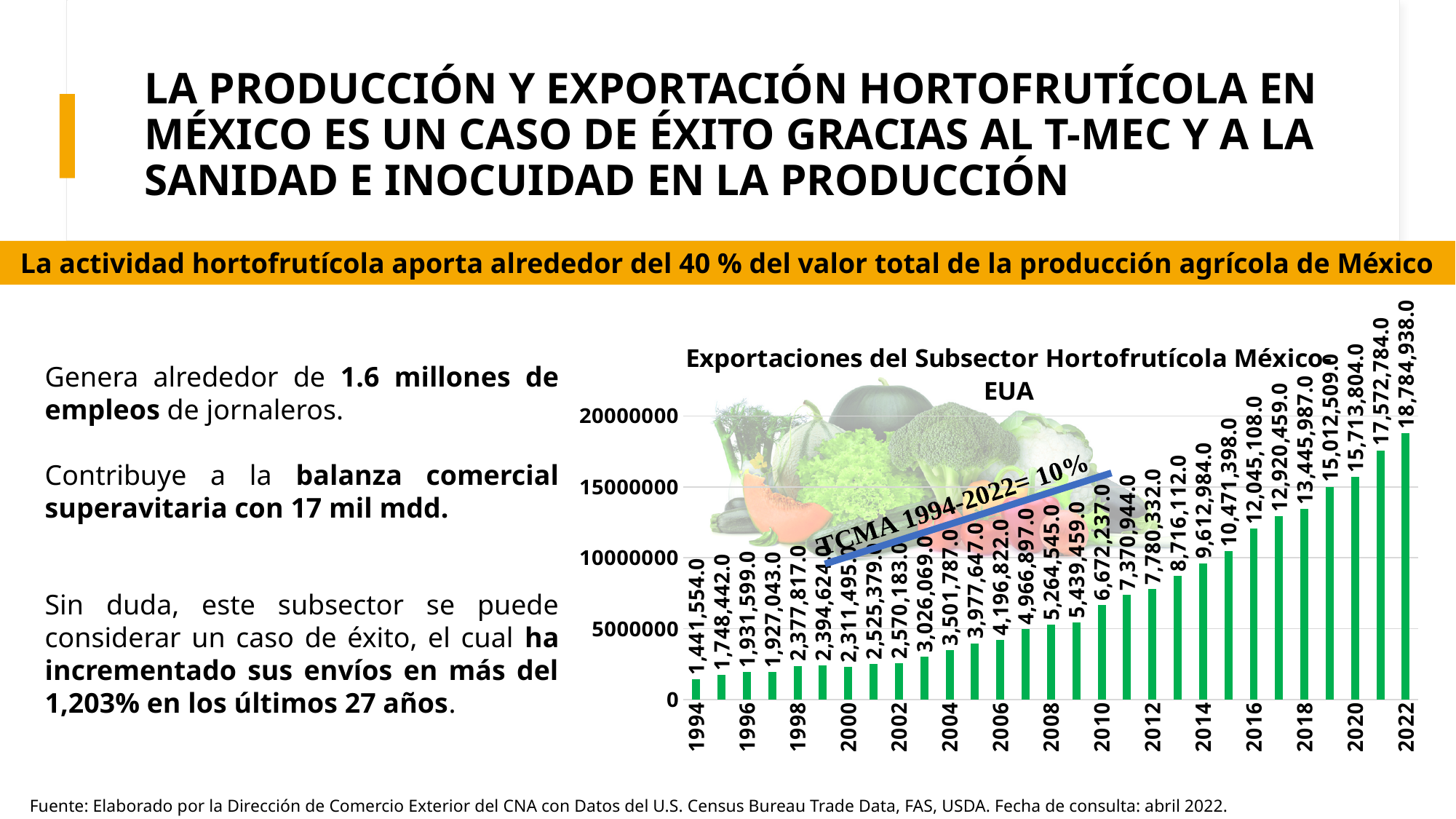
Which is larger, the value for 2014 or the value for 2018? 2018 Which year has the highest value? 2022 Do the values generally rise or fall from 1994 to 2022? Rise What is the difference between the values for 2022 and 1994? 17,343,384.0 What is the title of the chart? Exportaciones del Subsector Hortofrutícola México-EUA What is the value for 2016? 12,045,108.0 Is the value for 2014 greater or less than 10000000? less What is the value for 2022? 18,784,938.0 What is the value for 1994? 1,441,554.0 Which year has the lowest value? 1994 What kind of chart is shown on the slide? Bar chart What is the value for 2010? 6,672,237.0